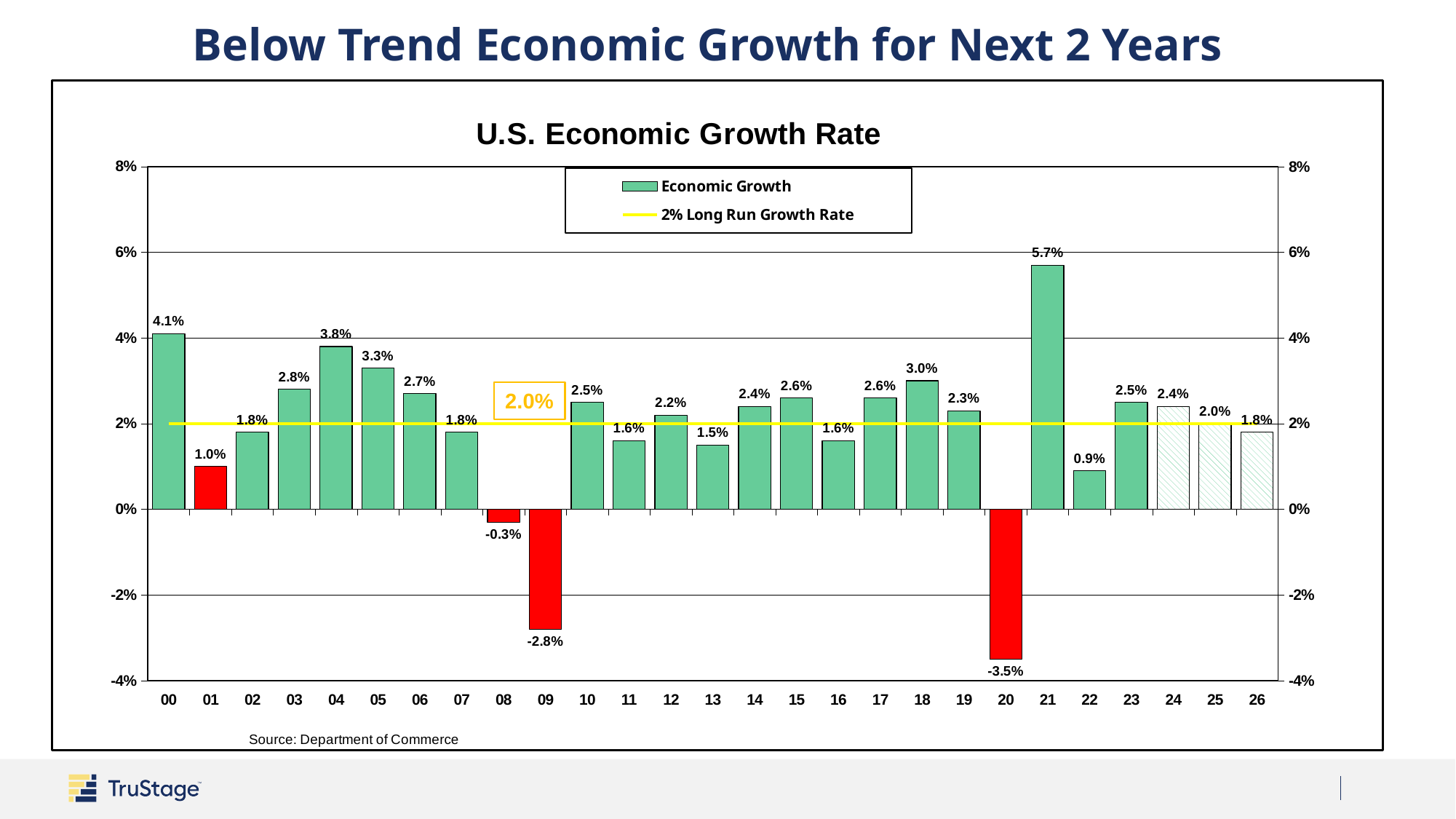
What is the title of the chart? U.S. Economic Growth Rate What is the difference between the growth rate in 21 and the growth rate in 22? 4.8% Which year has the lowest economic growth rate? 20 What value does the yellow horizontal line represent? 2% Long Run Growth Rate Which year has a higher growth rate, 04 or 18? 04 What is the economic growth rate shown for 26? 1.8% What kind of chart is this? combination bar and line chart Which year has the highest economic growth rate? 21 What is the economic growth rate shown for 09? -2.8% How many entries does the legend list? 2 What is the U.S. economic growth rate shown for 21? 5.7% How many years are shown on the x axis? 27